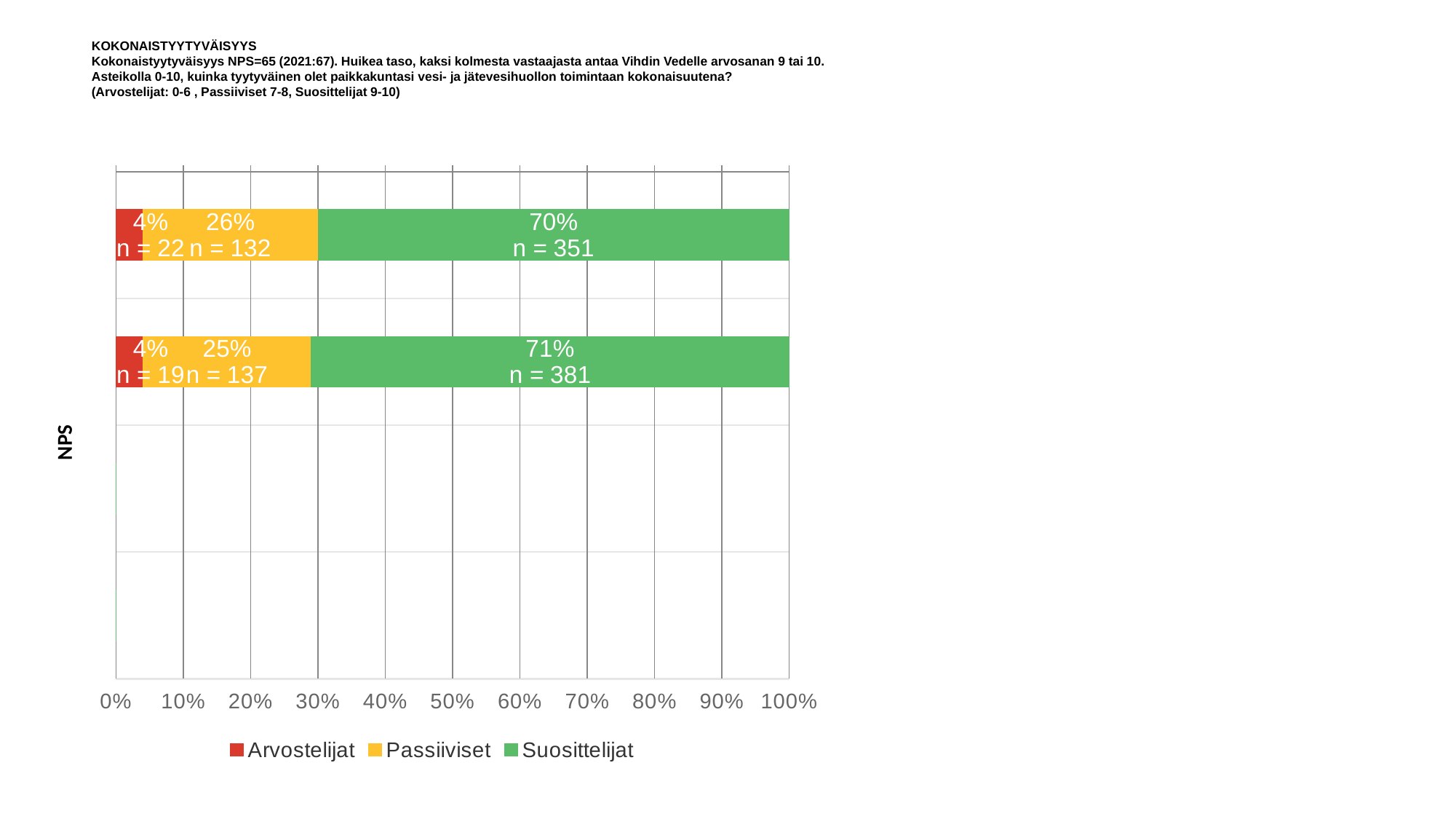
What is the n value shown for the Passiiviset segment in the bottom bar? n = 137 Which series has the smallest share in the bottom bar? Arvostelijat What percentage does the Suosittelijat segment show in the top bar? 70% What is the n value shown for the Suosittelijat segment in the bottom bar? n = 381 How many bars are plotted in the chart? 2 Which series has the largest share in the top bar? Suosittelijat Is the Passiiviset share larger in the top bar or the bottom bar? top bar What colour represents Suosittelijat in the legend? green How many series does the legend list? 3 What kind of chart is shown on the slide? bar chart What percentage does the Arvostelijat segment show in the top bar? 4% What is the difference between the Suosittelijat n values of the bottom bar (n = 381) and the top bar (n = 351)? 30